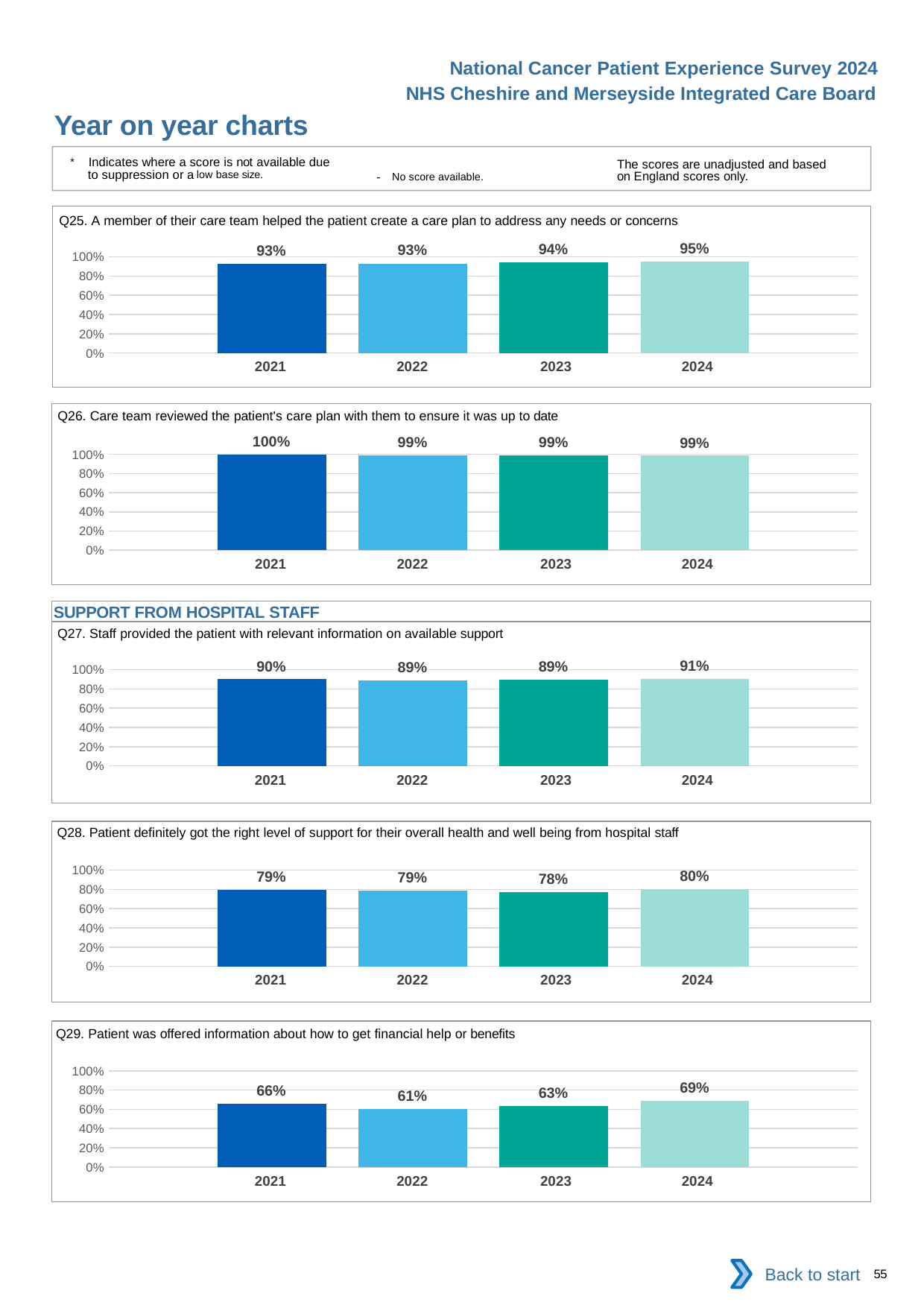
In the Q28 chart, which is larger, the value for 2023 or the value for 2024? 2024 In the Q29 chart, is the value for 2021 greater or less than 80%? less In the Q26 chart, which year has the highest value? 2021 In the Q26 chart, what is the value for 2021? 100% In the Q27 chart, what is the value for 2022? 89% In the Q25 chart, what is the value for 2024? 95% In the Q29 chart, which year has the lowest value? 2022 What kind of chart is the Q29 chart? bar chart How many years are shown in the Q28 chart? 4 In the Q29 chart, what is the difference between the 2024 value and the 2022 value? 8% In the Q25 chart, do the values rise or fall from 2021 to 2024? rise What is the section heading shown above the Q27 chart? SUPPORT FROM HOSPITAL STAFF